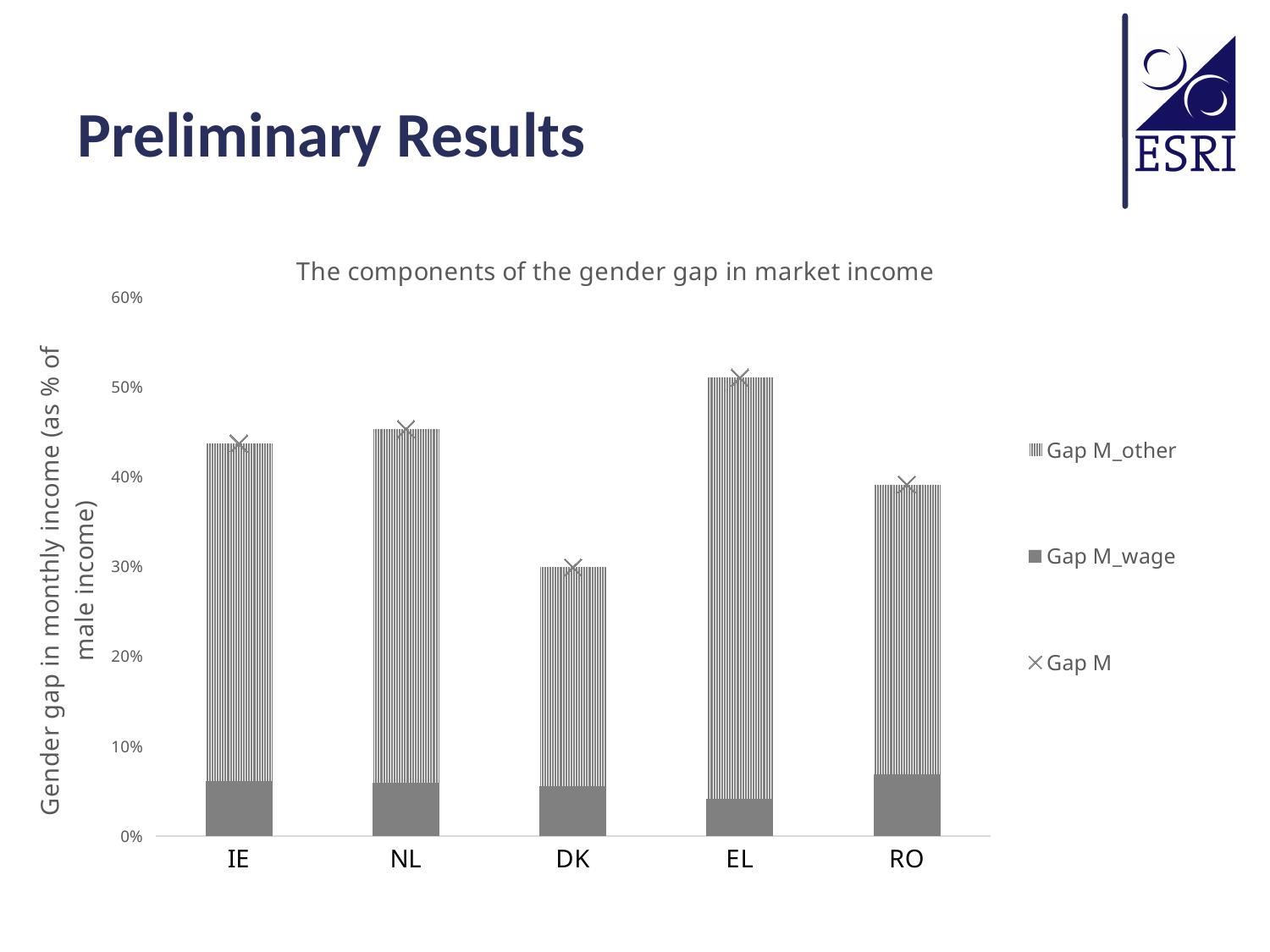
Which country has the lowest total gender gap in market income? DK How many series does the chart's legend list? 3 Which legend entry is shown with an x marker rather than a bar? Gap M Is the total gender gap for RO greater or less than 30%? greater What is the title of the chart? The components of the gender gap in market income Is the total gender gap for DK greater or less than 40%? less What kind of chart is shown on the slide? bar chart Which country has the highest total gender gap in market income? EL Is the total gender gap for IE greater or less than 40%? greater Which is larger, the total gender gap for EL or for DK? EL How many countries are shown on the x axis of the chart? 5